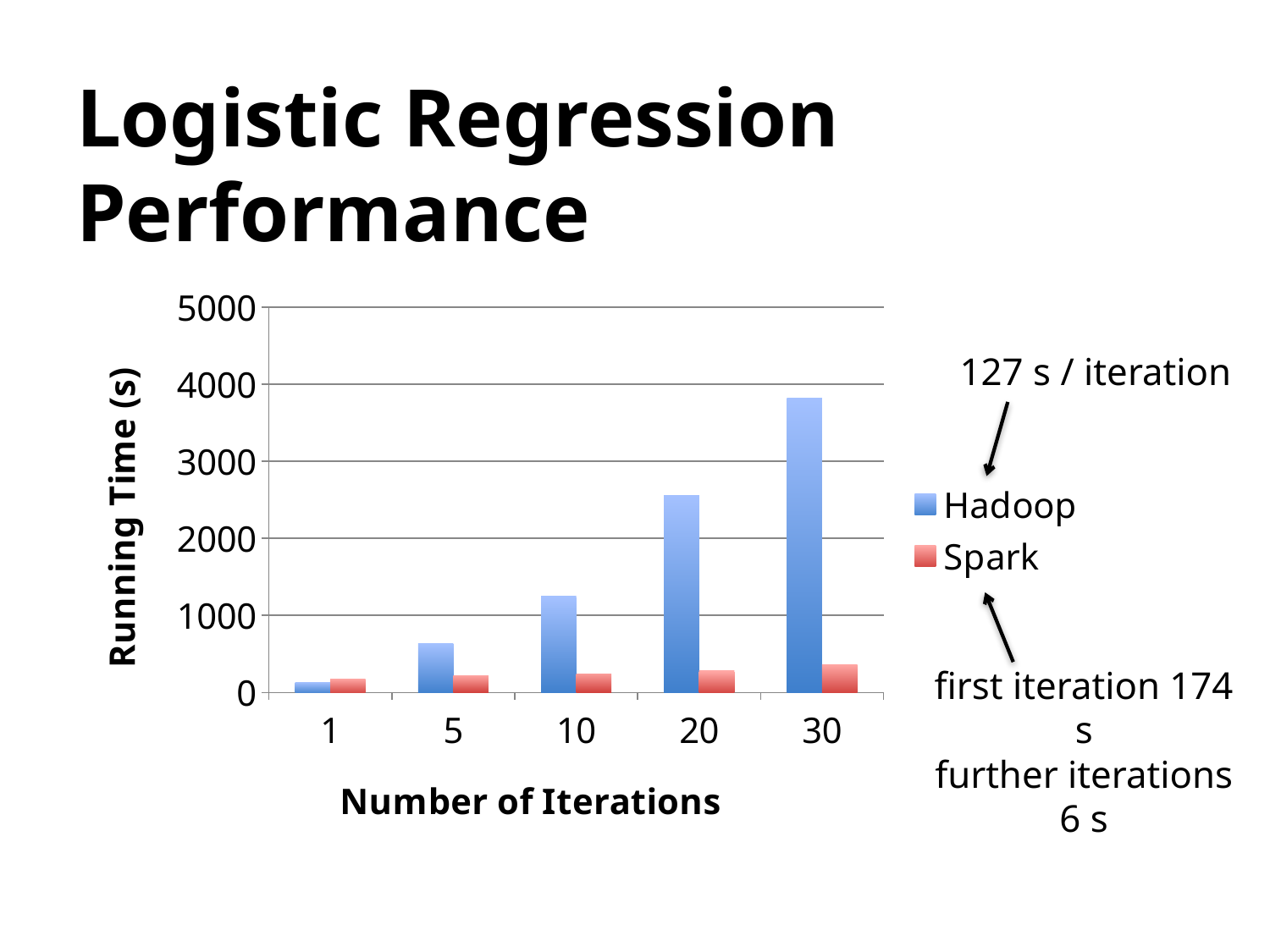
Is the Hadoop running time at 30 iterations greater or less than 3000? greater Is the Hadoop running time at 20 iterations greater or less than 3000? less How many series does the legend list? 2 At which number of iterations is the Hadoop running time lowest? 1 What is the label of the y axis? Running Time (s) At which number of iterations is the Hadoop running time highest? 30 Does the Hadoop running time rise or fall as the number of iterations increases? rise How many iteration counts are shown on the x axis? 5 Is the Spark running time at 30 iterations greater or less than 1000? less At 30 iterations, which has the larger running time, Hadoop or Spark? Hadoop What kind of chart is shown on the slide? bar chart